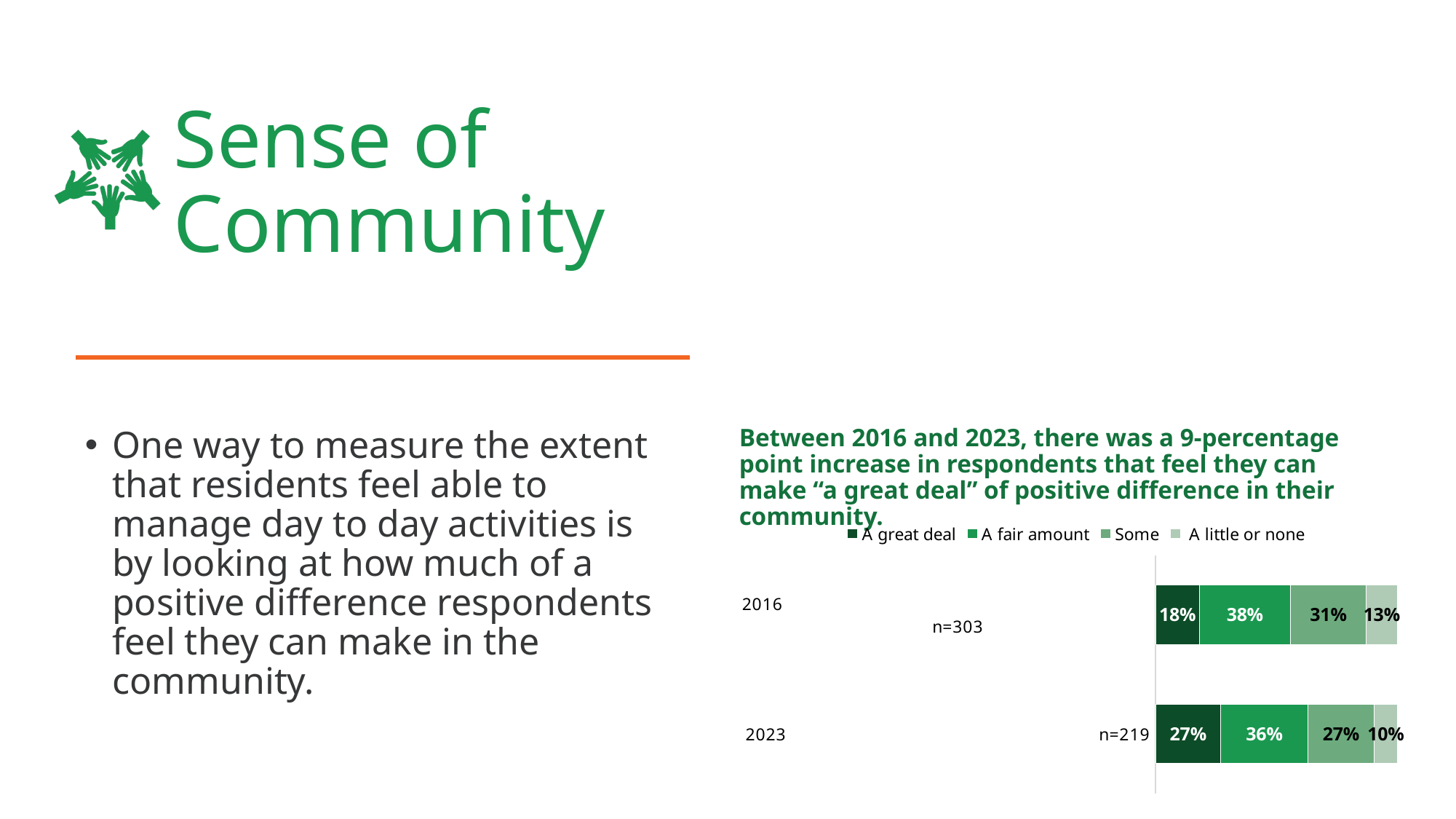
Which year has the larger value for "A little or none"? 2016 What is the difference between the "Some" values for 2016 and 2023? 4 How many series does the legend list? 4 By how many percentage points did "A great deal" increase from 2016 to 2023? 9 What percentage of respondents in 2016 said they can make "A great deal" of positive difference? 18% What is the value for "A fair amount" in 2023? 36% What is the value for "Some" in 2016? 31% Which response category has the highest value in 2016? A fair amount What kind of chart is shown on the slide? Stacked bar chart What is the value for "A little or none" in 2023? 10% What percentage of respondents in 2023 said they can make "A great deal" of positive difference? 27% What is the sample size (n) shown for 2023? n=219